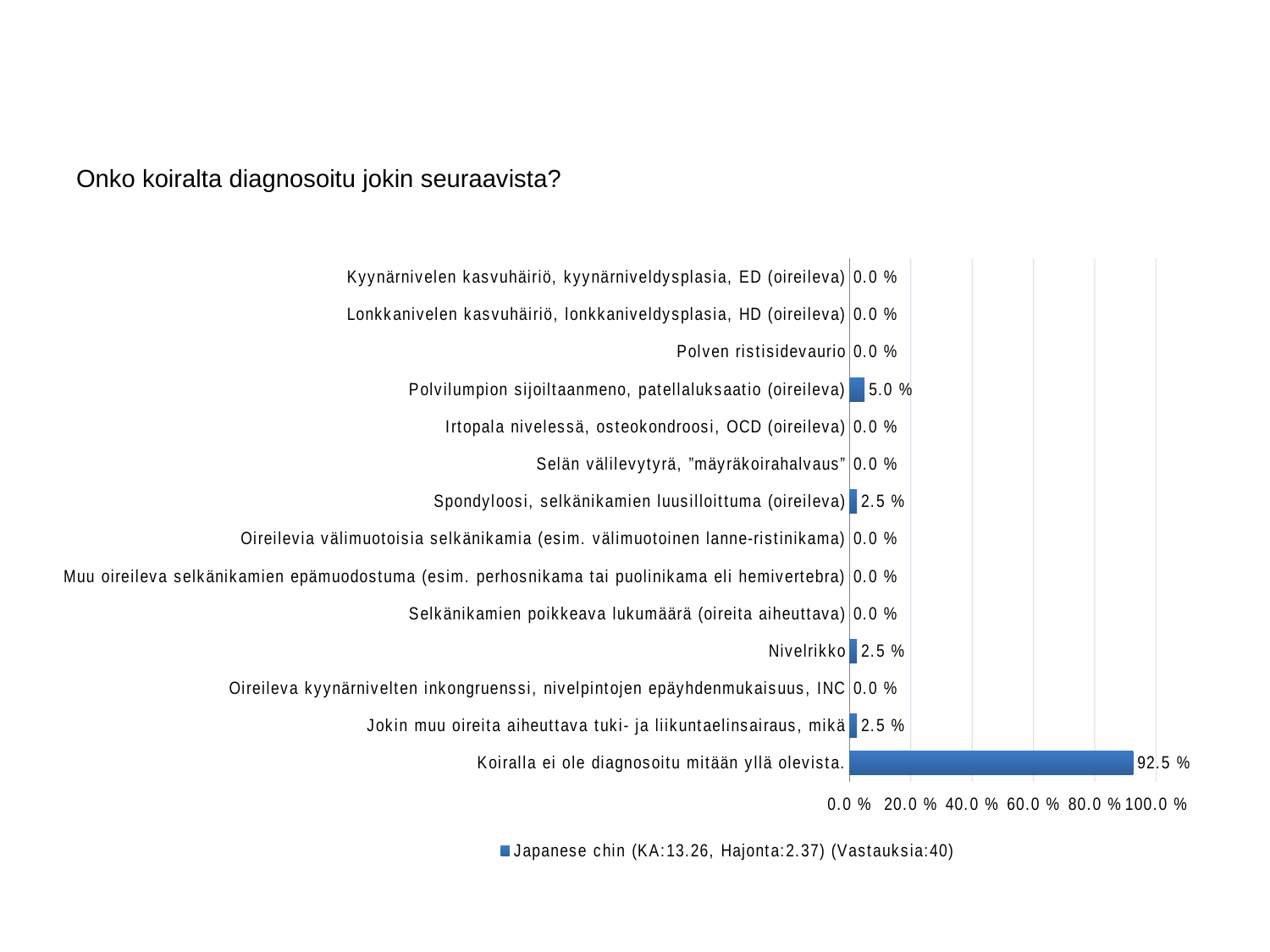
What is the value for "Polvilumpion sijoiltaanmeno, patellaluksaatio (oireileva)"? 5.0 % What is the value for "Polven ristisidevaurio"? 0.0 % What is the value for "Koiralla ei ole diagnosoitu mitään yllä olevista."? 92.5 % What kind of chart is shown on the slide? bar chart Is the value for "Koiralla ei ole diagnosoitu mitään yllä olevista." greater or less than 80.0 %? greater Which is larger, the value for "Polvilumpion sijoiltaanmeno, patellaluksaatio (oireileva)" or the value for "Nivelrikko"? Polvilumpion sijoiltaanmeno, patellaluksaatio (oireileva) Which category has the highest value? Koiralla ei ole diagnosoitu mitään yllä olevista. What is the difference between the values for "Polvilumpion sijoiltaanmeno, patellaluksaatio (oireileva)" and "Spondyloosi, selkänikamien luusilloittuma (oireileva)"? 2.5 % How many categories are shown in the chart? 14 What is the difference between the values for "Koiralla ei ole diagnosoitu mitään yllä olevista." and "Polvilumpion sijoiltaanmeno, patellaluksaatio (oireileva)"? 87.5 % What is the legend entry of the chart? Japanese chin (KA:13.26, Hajonta:2.37) (Vastauksia:40) What is the value for "Nivelrikko"? 2.5 %